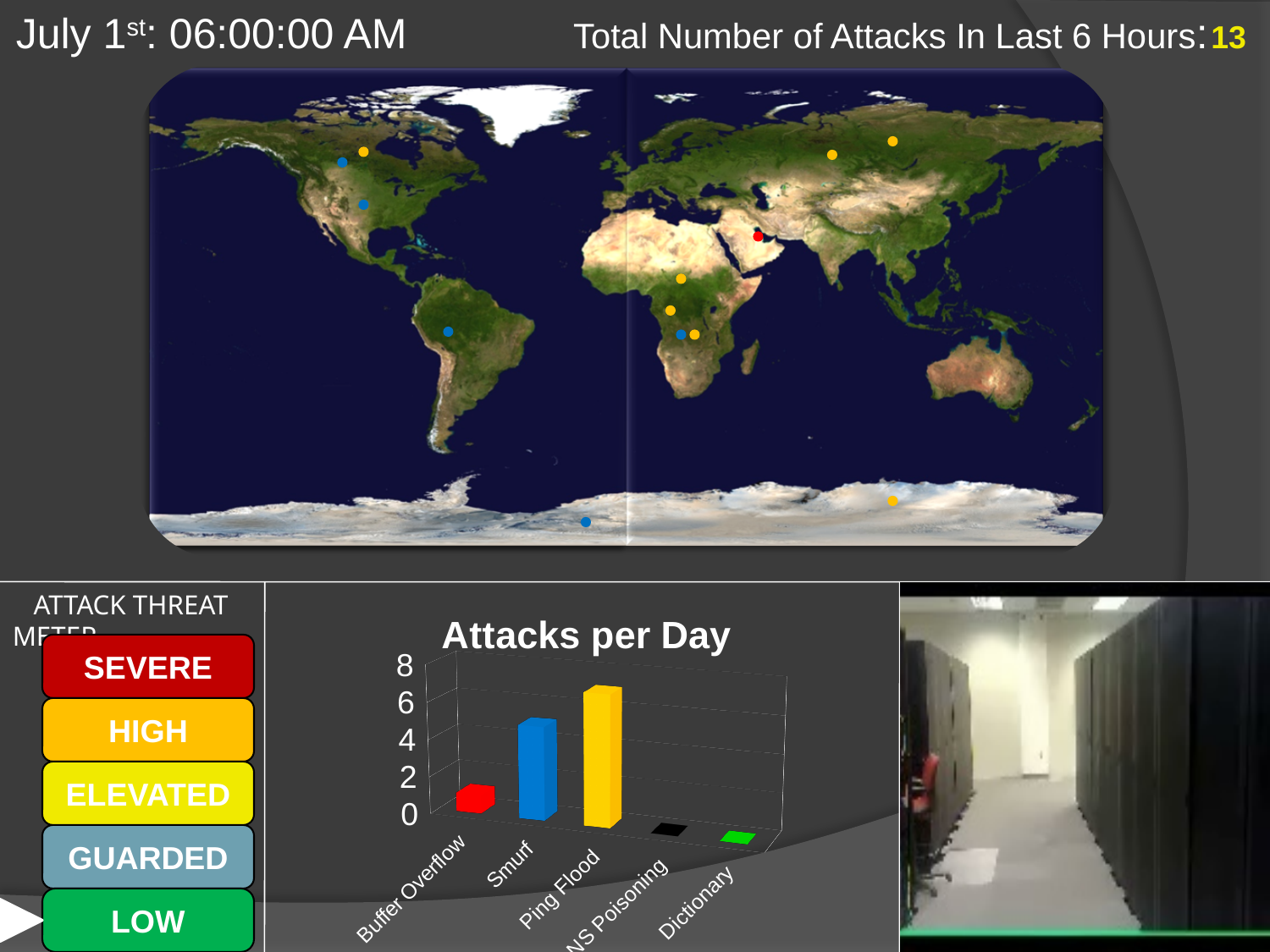
In the "Attacks per Day" chart, which is larger, Buffer Overflow or Smurf? Smurf What kind of chart is the "Attacks per Day" chart? bar chart In the "Attacks per Day" chart, is the value for Buffer Overflow greater or less than 2? less In the "Attacks per Day" chart, is the value for Ping Flood greater or less than 6? greater What is the highest value shown on the vertical axis of the "Attacks per Day" chart? 8 In the "Attacks per Day" chart, is the value for Smurf greater or less than 4? greater In the "Attacks per Day" chart, which is larger, Smurf or Ping Flood? Ping Flood What is the title of the bar chart at the bottom of the slide? Attacks per Day In the "Attacks per Day" chart, which attack type has the highest value? Ping Flood How many attack categories are shown on the x axis of the "Attacks per Day" chart? 5 In the "Attacks per Day" chart, which is larger, Dictionary or Ping Flood? Ping Flood